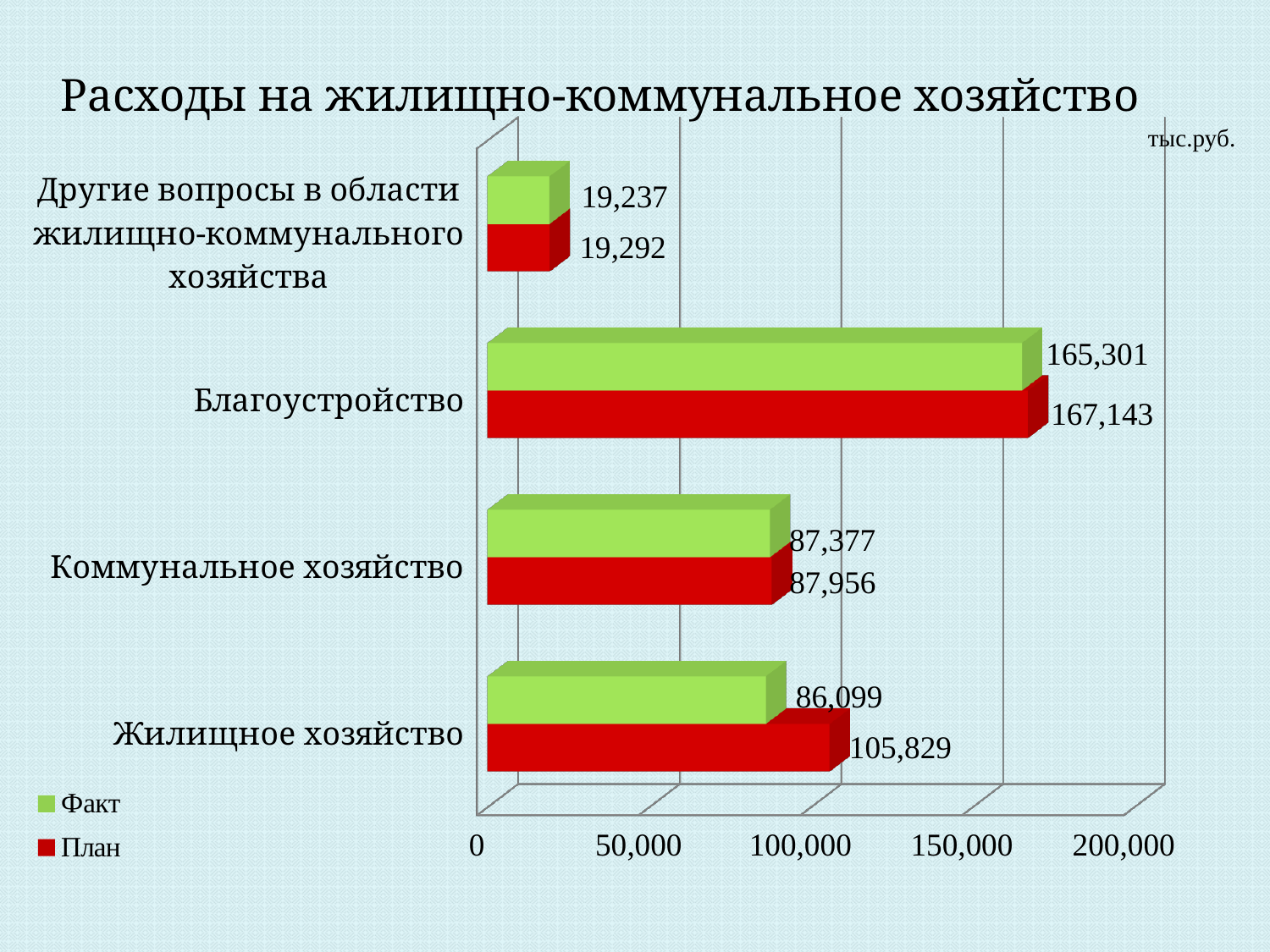
What is the План value for Жилищное хозяйство? 105,829 What is the Факт value for Благоустройство? 165,301 Is the Факт value for Жилищное хозяйство greater or less than 100,000? less How many categories are shown on the chart? 4 What is the План value for Другие вопросы в области жилищно-коммунального хозяйства? 19,292 What kind of chart is shown on the slide? bar chart Which is larger: the Факт value for Коммунальное хозяйство or the Факт value for Благоустройство? Благоустройство Which category has the lowest План value? Другие вопросы в области жилищно-коммунального хозяйства What is the difference between the План and Факт values for Благоустройство? 1,842 What is the difference between the План and Факт values for Жилищное хозяйство? 19,730 Which category has the highest Факт value? Благоустройство How many series does the legend list? 2